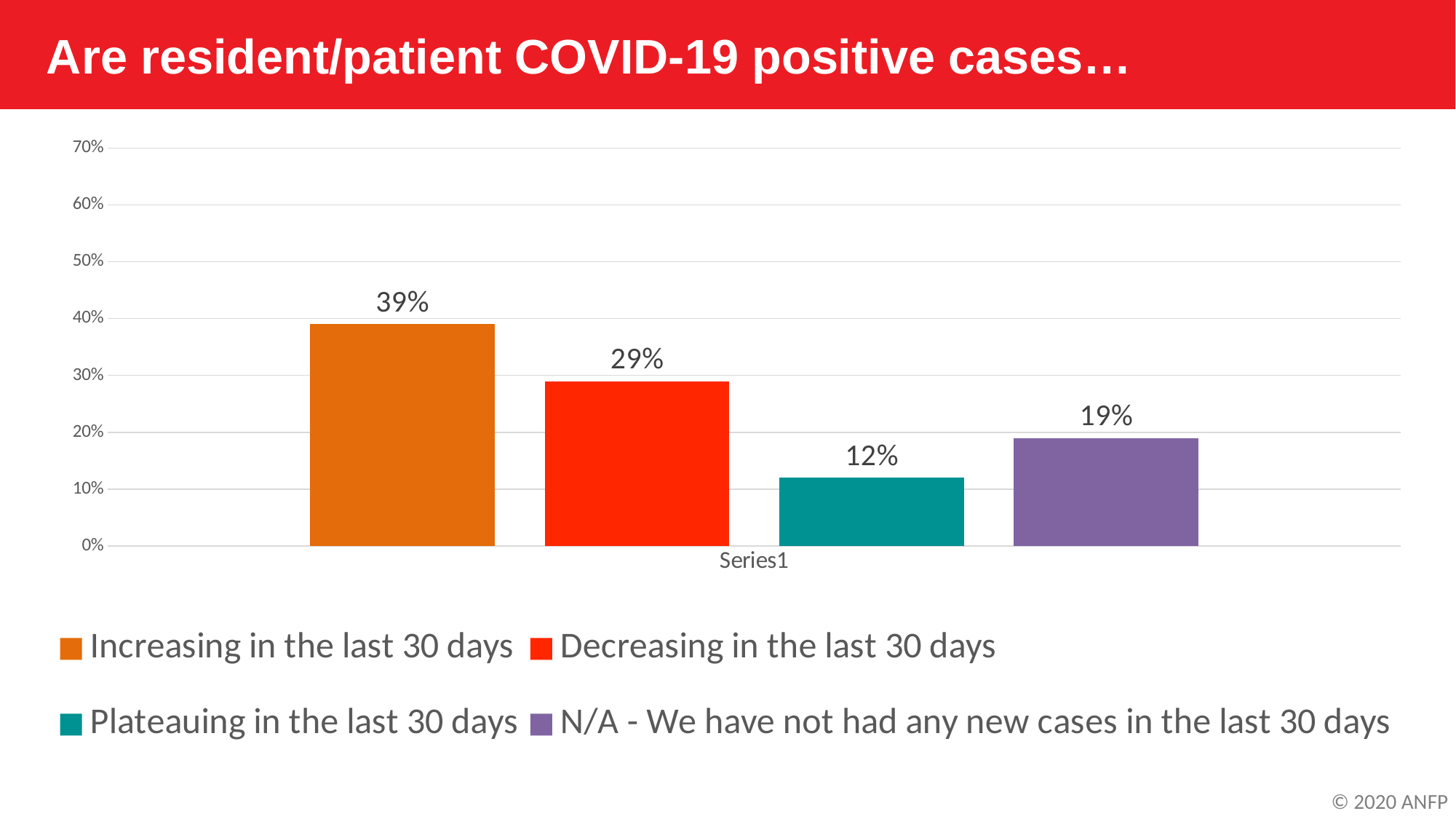
What percentage of respondents reported cases plateauing in the last 30 days? 12% Is the value for 'Decreasing in the last 30 days' greater or less than 30%? less What kind of chart is shown on the slide? Bar chart Which response has the lowest percentage? Plateauing in the last 30 days Which response has the highest percentage? Increasing in the last 30 days Which is larger: the percentage for 'Plateauing in the last 30 days' or for 'N/A - We have not had any new cases in the last 30 days'? N/A - We have not had any new cases in the last 30 days What percentage of respondents answered N/A - We have not had any new cases in the last 30 days? 19% What is the difference in percentage points between 'Increasing in the last 30 days' and 'Decreasing in the last 30 days'? 10% What percentage of respondents reported cases decreasing in the last 30 days? 29% How many bars are shown in the chart? 4 What percentage of respondents reported cases increasing in the last 30 days? 39% What colour is the bar for 'Plateauing in the last 30 days'? Teal